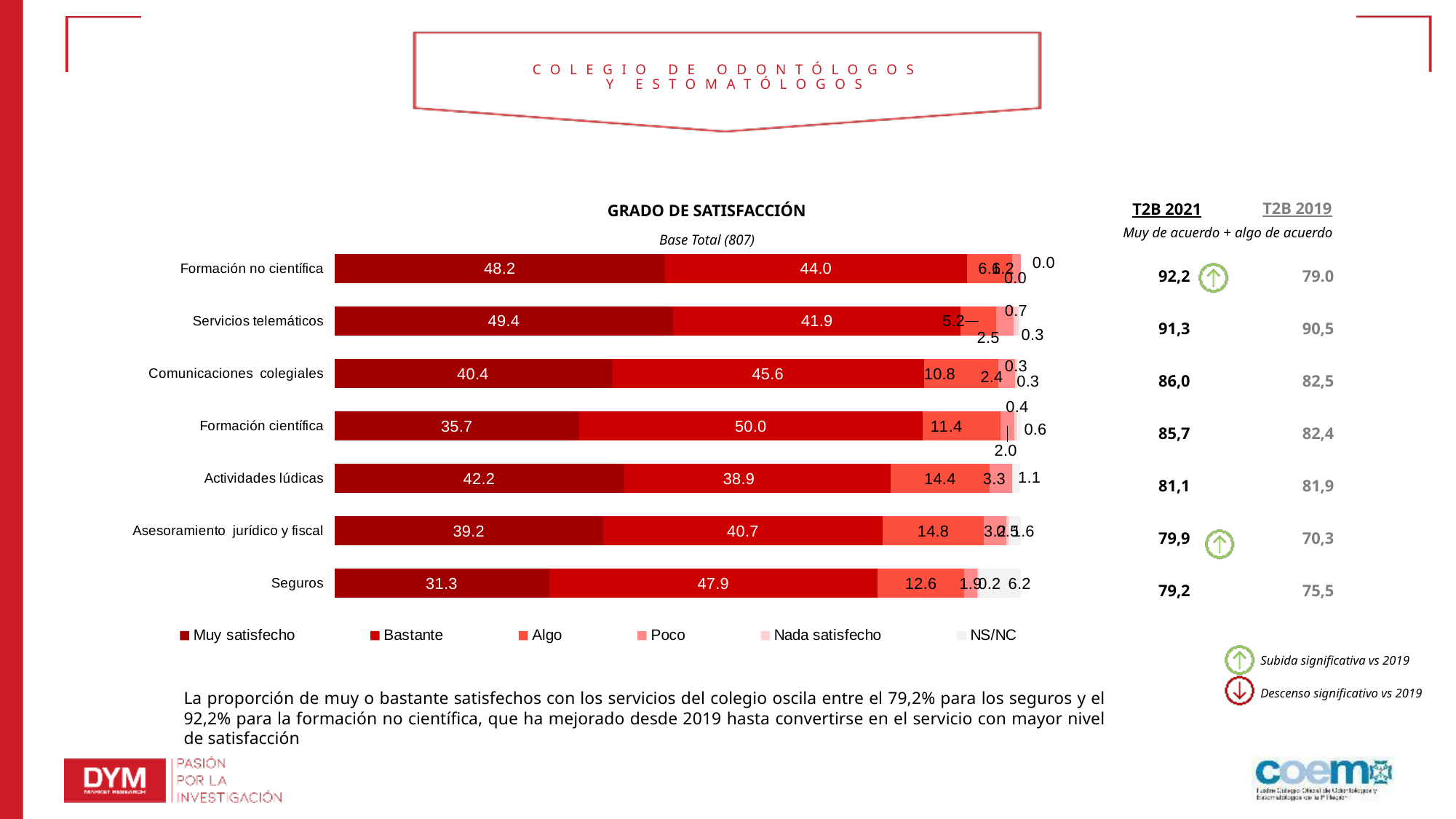
What is the difference between the 'Bastante' values for Formación científica and Actividades lúdicas? 11.1 How many service categories are plotted in the GRADO DE SATISFACCIÓN chart? 7 Which is larger: the 'Algo' value for Comunicaciones colegiales or for Seguros? Seguros What is the 'Bastante' value for Formación científica? 50.0 How many series does the legend of the GRADO DE SATISFACCIÓN chart list? 6 Which category has the lowest 'Muy satisfecho' value? Seguros What is the 'Muy satisfecho' value for Servicios telemáticos? 49.4 Which category has the highest 'Muy satisfecho' value? Servicios telemáticos What is the 'Algo' value for Asesoramiento jurídico y fiscal? 14.8 What base size is stated under the chart title? Base Total (807) What is the T2B 2021 value shown for Formación no científica? 92,2 What type of chart is shown on the slide? stacked bar chart